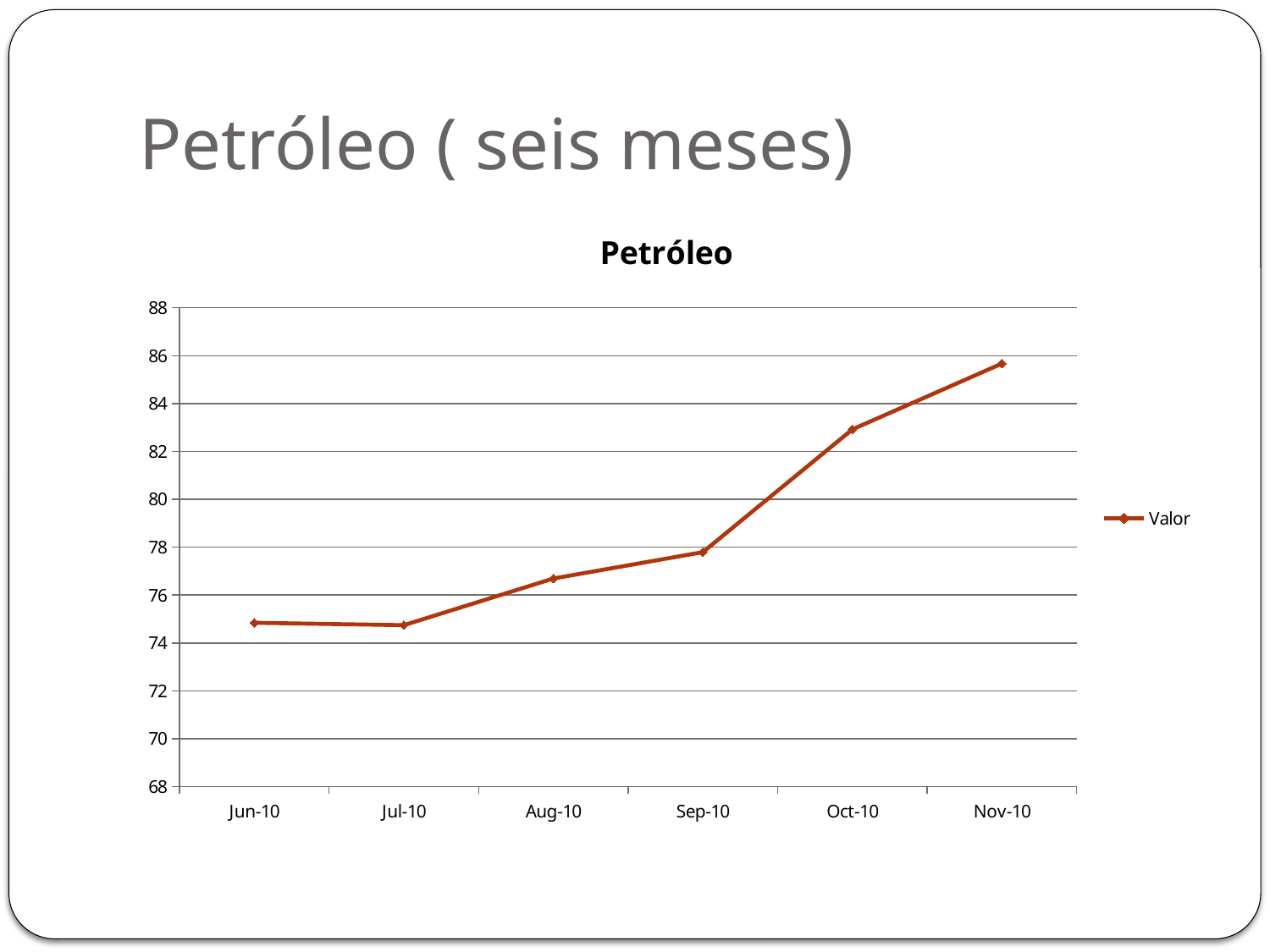
How many series does the legend list? 1 What is the title of the chart? Petróleo Is the value for Nov-10 greater or less than 84? greater What is the name of the series shown in the legend? Valor Is the value for Jun-10 greater or less than 76? less Which month has the highest value? Nov-10 Which is larger, the value for Sep-10 or the value for Oct-10? Oct-10 Is the value for Oct-10 greater or less than 82? greater Do the values generally rise or fall from Jun-10 to Nov-10? rise What kind of chart is shown on the slide? line chart How many months are plotted on the x axis? 6